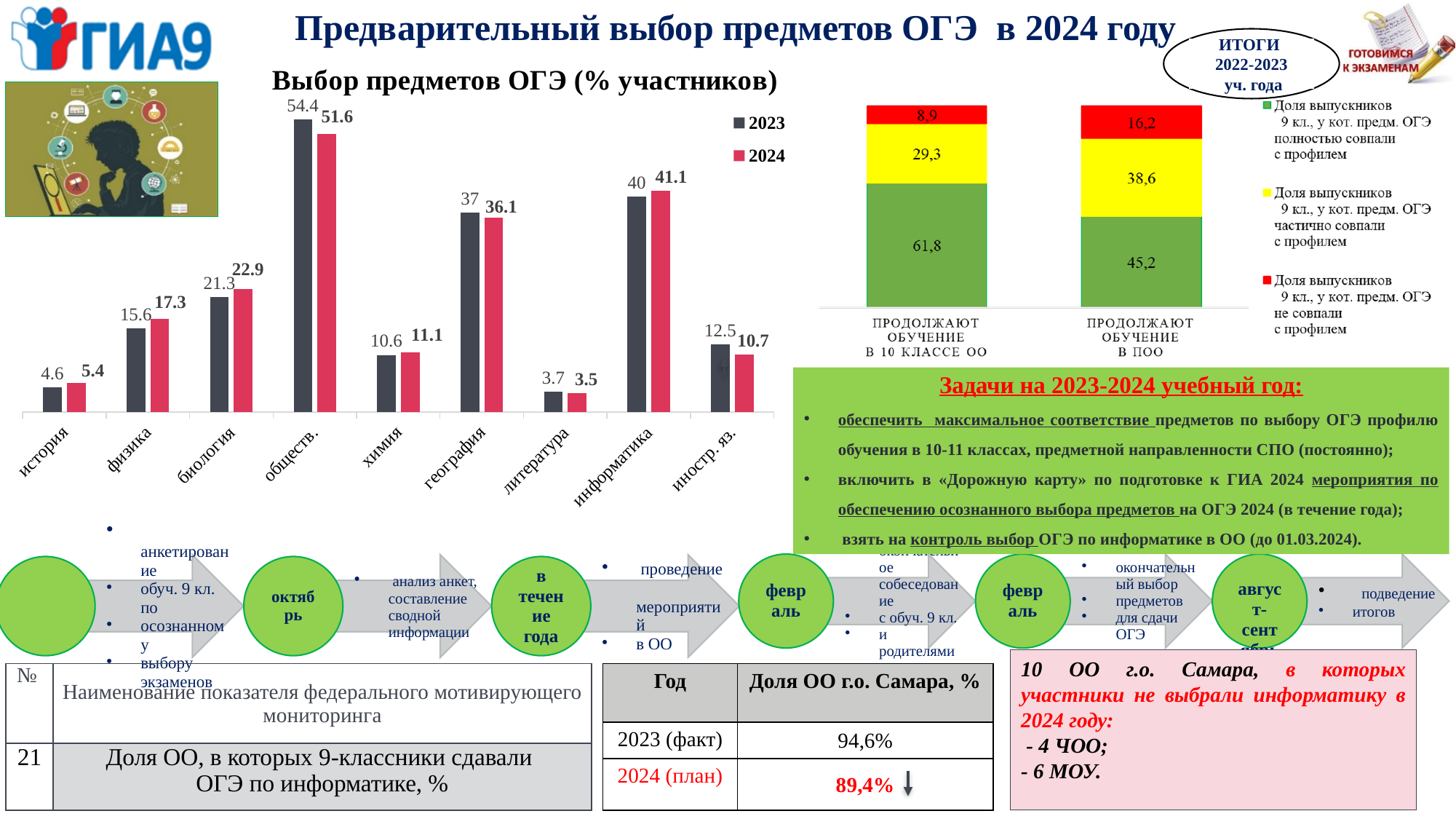
In the bar chart "Выбор предметов ОГЭ (% участников)", what is the 2023 value for обществ.? 54.4 How many series does the legend of the bar chart "Выбор предметов ОГЭ (% участников)" list? 2 How many subjects are shown on the x axis of the bar chart "Выбор предметов ОГЭ (% участников)"? 9 In the bar chart "Выбор предметов ОГЭ (% участников)", which subject has the highest 2024 value? обществ. In the bar chart "Выбор предметов ОГЭ (% участников)", is the 2023 value for иностр. яз. larger or smaller than the 2024 value? larger In the bar chart "Выбор предметов ОГЭ (% участников)", which subject has the lowest 2023 value? литература In the bar chart "Выбор предметов ОГЭ (% участников)", what is the difference between the 2024 and 2023 values for физика? 1.7 In the stacked bar chart on the right, what is the value of the green segment for "Продолжают обучение в ПОО"? 45,2 In the stacked bar chart on the right, what is the total of the bar "Продолжают обучение в 10 классе ОО"? 100 In the bar chart "Выбор предметов ОГЭ (% участников)", what is the 2024 value for информатика? 41.1 In the stacked bar chart on the right, which colour represents "Доля выпускников 9 кл., у кот. предм. ОГЭ не совпали с профилем"? red What kind of chart is "Выбор предметов ОГЭ (% участников)"? bar chart